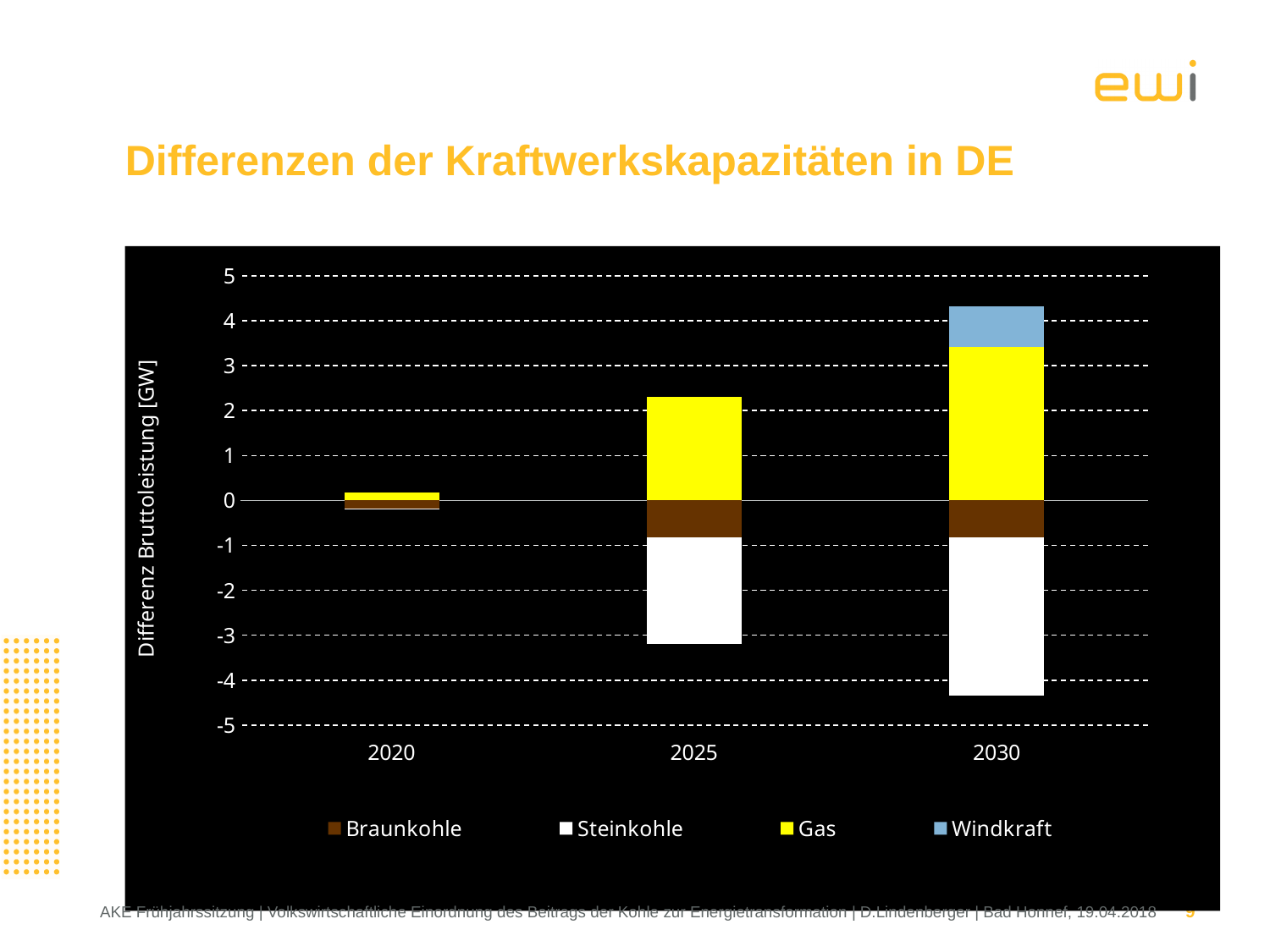
Is the bottom of the Steinkohle segment for 2030 greater or less than -4? less Which series appears only in the 2030 bar? Windkraft Which year has the smallest bars overall? 2020 Is the bottom of the Steinkohle segment for 2025 greater or less than -3? less Is the top of the Gas segment for 2030 greater or less than 3? greater What kind of chart is shown on the slide? stacked bar chart Which year has the larger Gas segment, 2025 or 2030? 2030 How many years (categories) are shown on the x axis? 3 What is the title of the y axis? Differenz Bruttoleistung [GW] How many series does the legend list? 4